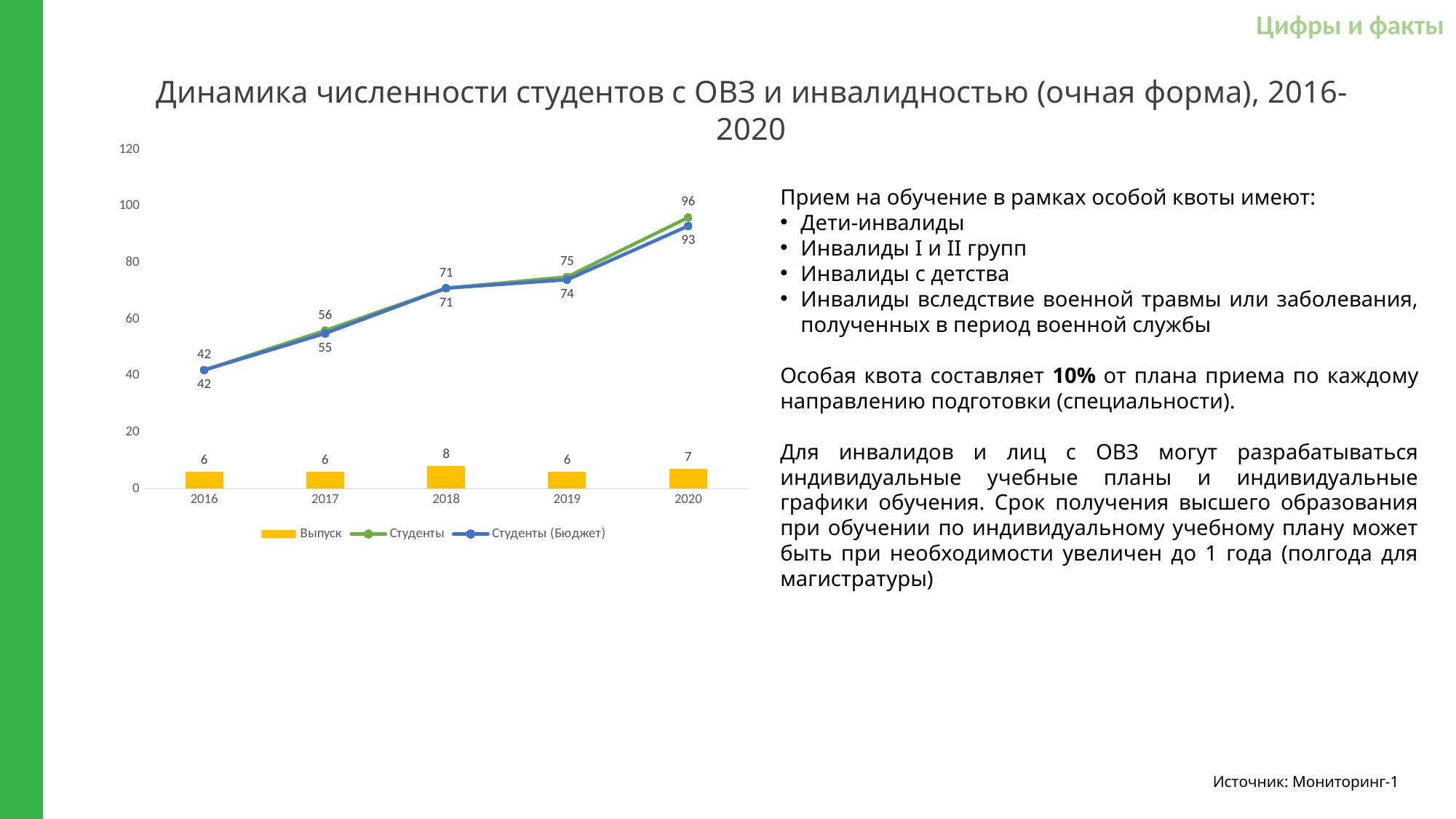
In which year is Выпуск highest? 2018 What is the difference between Студенты and Студенты (Бюджет) in 2020? 3 How many series does the legend list? 3 Does the Студенты series rise or fall from 2016 to 2020? rise What is the value of Студенты in 2020? 96 How many years are shown on the x axis? 5 Which is larger in 2017: Студенты or Студенты (Бюджет)? Студенты What is the value of Студенты (Бюджет) in 2019? 74 By how much did Студенты increase from 2016 to 2020? 54 What is the value of Выпуск in 2018? 8 In which year is Студенты lowest? 2016 Which series is shown as yellow bars? Выпуск